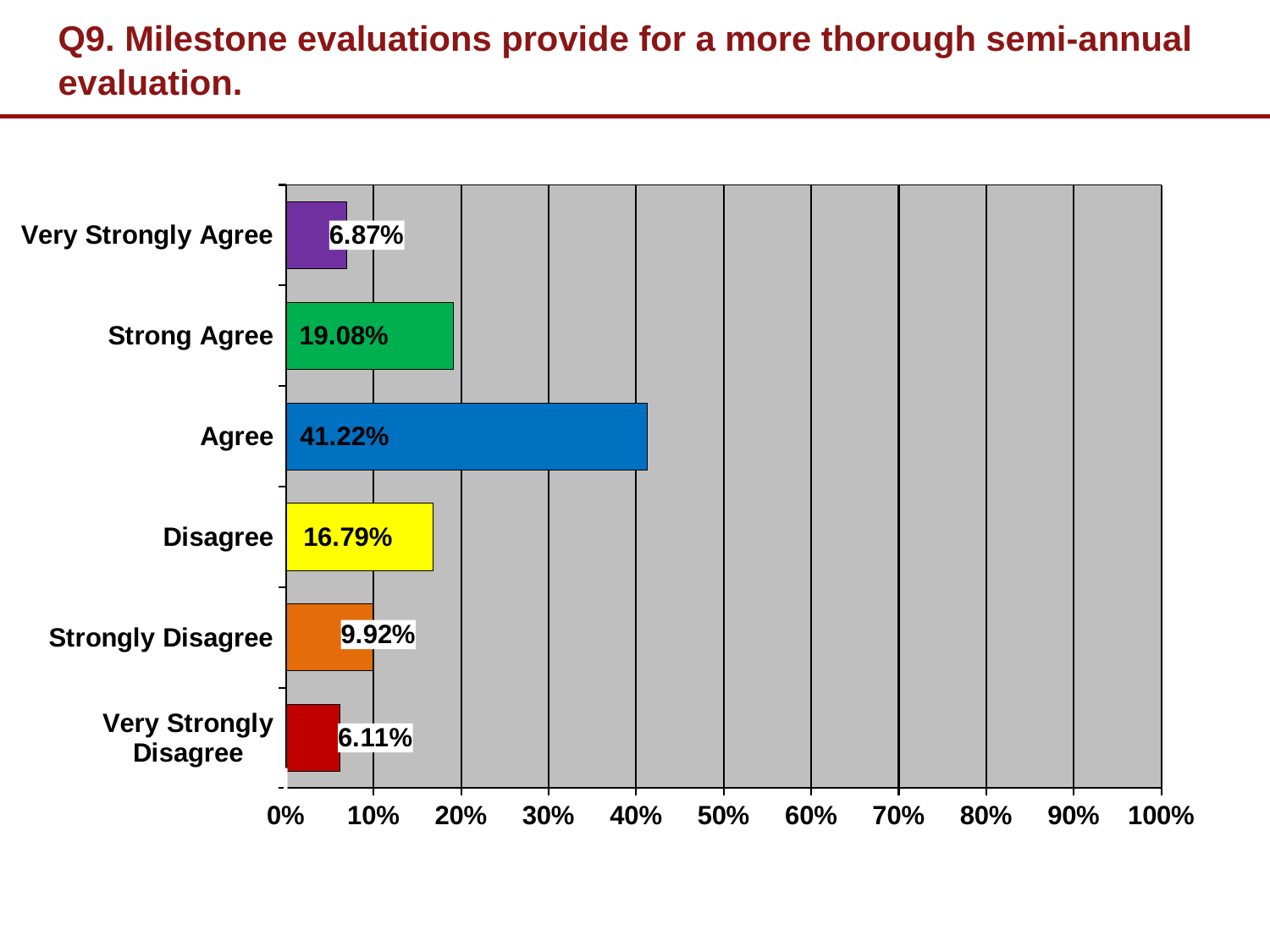
What percentage of respondents chose "Agree"? 41.22% What is the value shown for "Strongly Disagree"? 9.92% What is the difference between the "Agree" and "Strong Agree" percentages? 22.14% What type of chart is shown on the slide? Bar chart Which is larger, the value for "Strong Agree" or the value for "Disagree"? Strong Agree What colour is the bar for "Disagree"? Yellow Which response category has the highest percentage? Agree What percentage is shown for "Very Strongly Agree"? 6.87% How many response categories are shown in the chart? 6 Is the value for "Agree" greater or less than 40%? greater Which response category has the lowest percentage? Very Strongly Disagree What is the difference between the "Disagree" and "Strongly Disagree" percentages? 6.87%